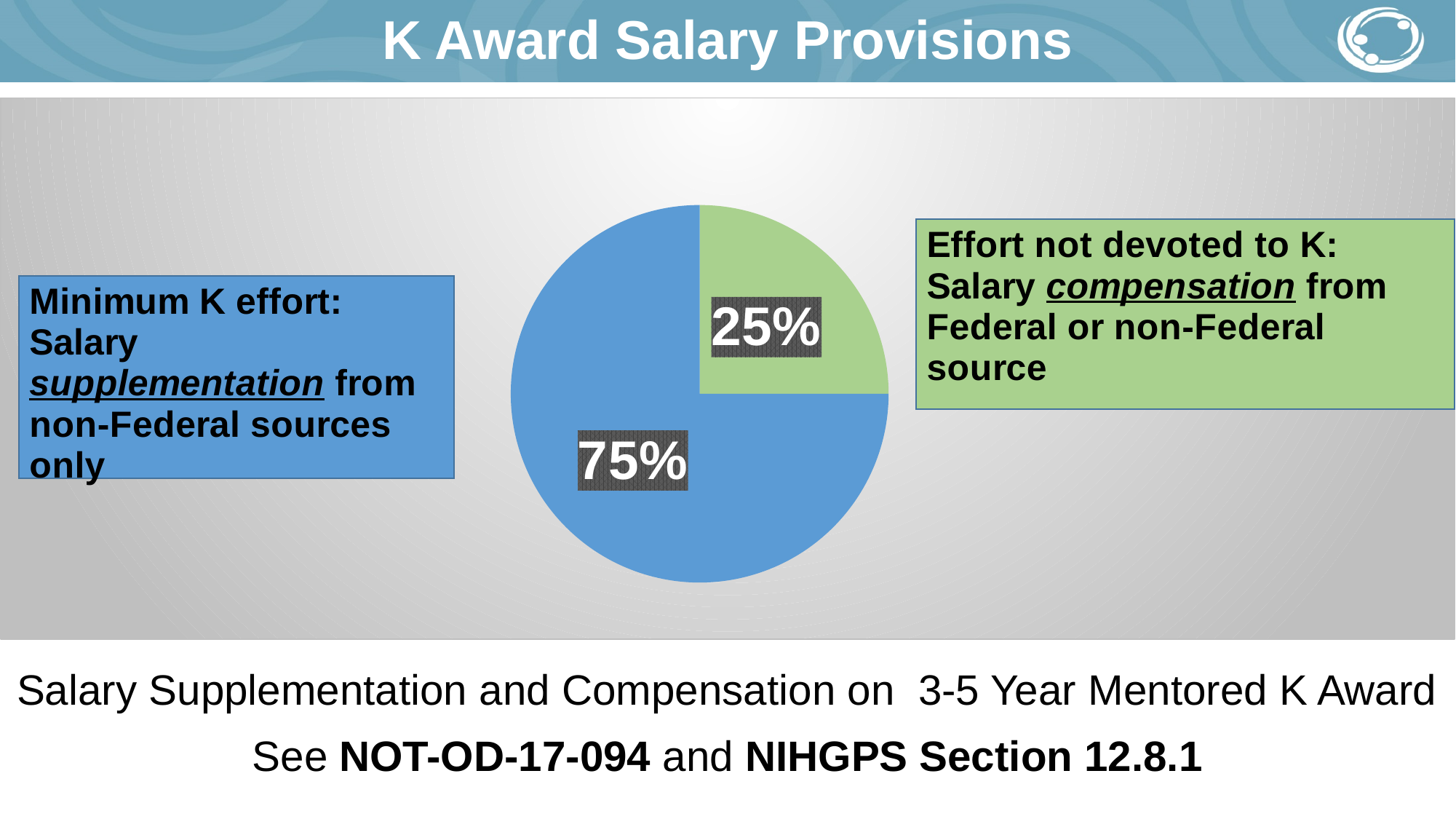
What is the difference in percentage points between the 75% slice and the 25% slice? 50 What share of the pie does the green slice (Effort not devoted to K) represent? 25% What share of the pie does the blue slice (Minimum K effort) represent? 75% Which is larger: the blue slice or the green slice? the blue slice Which slice of the pie is the smallest? Effort not devoted to K (25%) Which slice of the pie is the largest? Minimum K effort (75%) What colour is the slice labelled 75%? blue How many slices does the pie chart have? 2 What is the title of the slide containing the pie chart? K Award Salary Provisions What kind of chart is shown on the slide? pie chart What is the total of the two slices shown in the pie chart? 100%